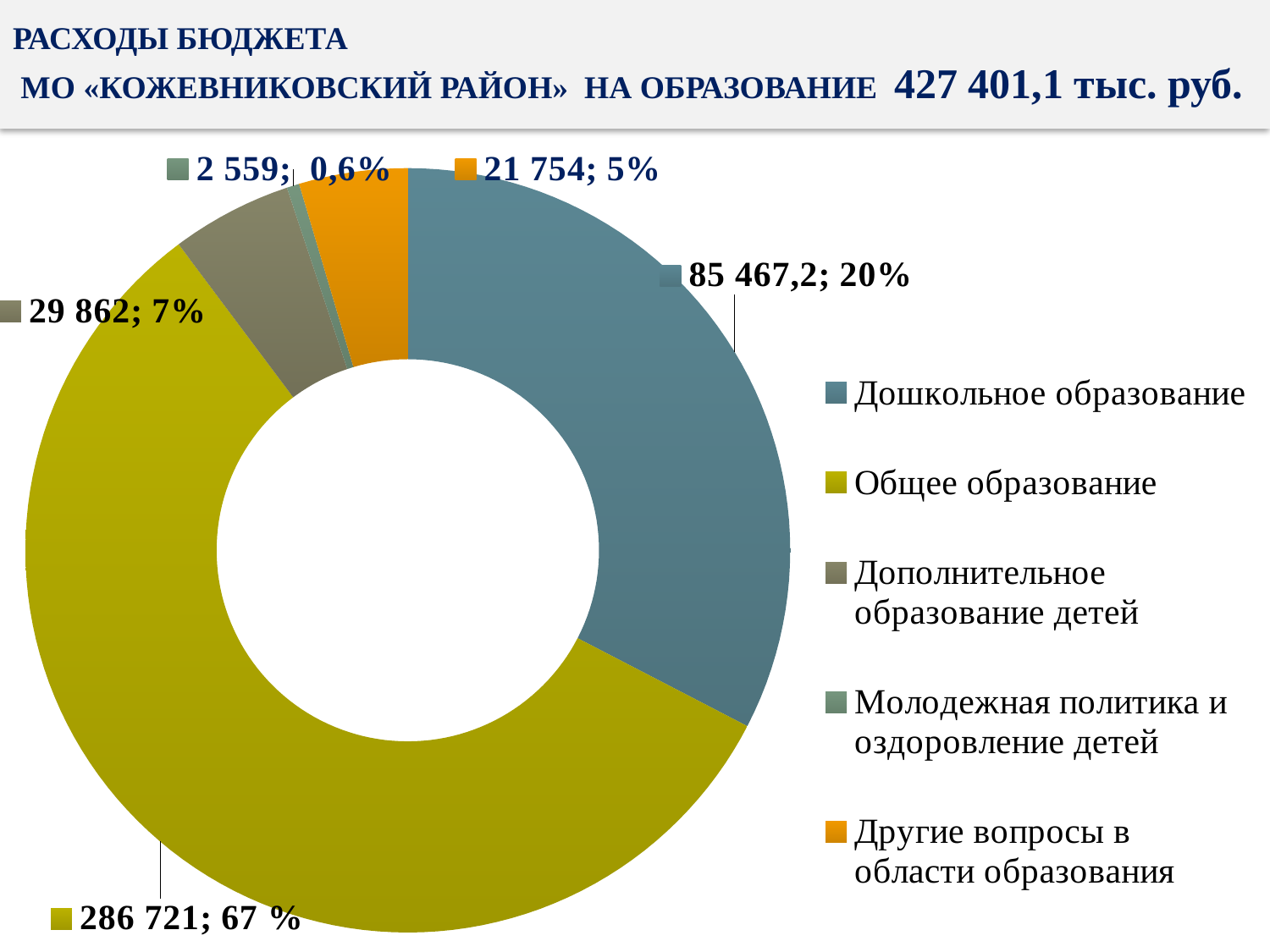
What share of the pie does Дошкольное образование take? 20% Which is larger, Дополнительное образование детей or Другие вопросы в области образования? Дополнительное образование детей Which category has the smallest slice? Молодежная политика и оздоровление детей What is the value for Молодежная политика и оздоровление детей? 2 559 What is the value for Другие вопросы в области образования? 21 754 How many categories does the legend list? 5 What kind of chart is shown on the slide? pie (doughnut) chart What is the value for Общее образование? 286 721 What is the value for Дополнительное образование детей? 29 862 What is the difference between the values for Дошкольное образование and Другие вопросы в области образования? 63 713,2 What is the value for Дошкольное образование? 85 467,2 Which category has the largest slice? Общее образование